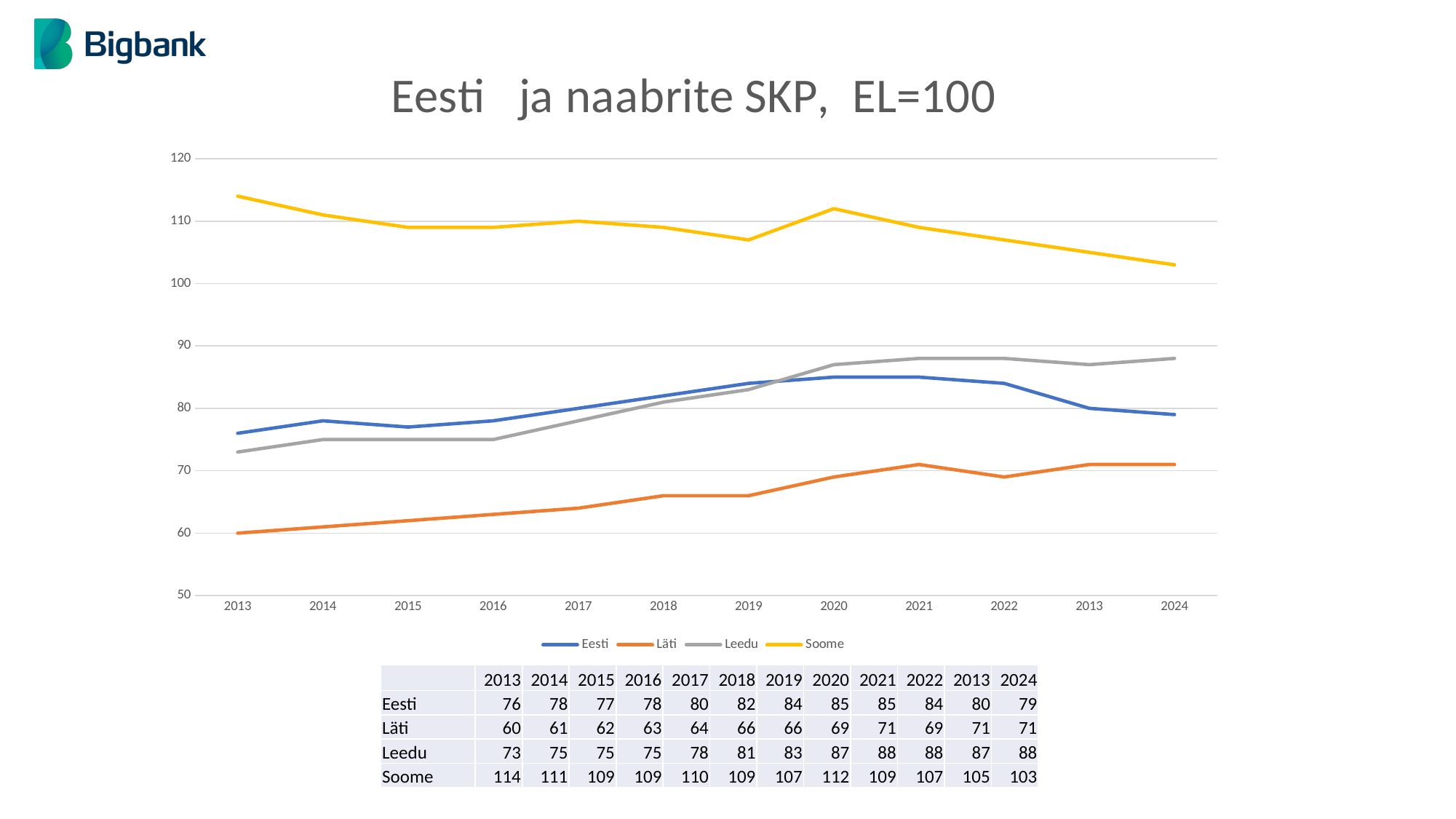
What is the value for Eesti in 2020? 85 How many series does the legend list? 4 Which series has the highest value in 2024? Soome Does the Soome line generally rise or fall from 2013 to 2024? fall What type of chart is shown on the slide? line chart Which series has the lowest value in 2014? Läti What is the difference between the Soome and Eesti values in 2024? 24 What is the title of the chart? Eesti ja naabrite SKP, EL=100 What is the value for Leedu in 2018? 81 What is the value for Soome in 2024? 103 Which is larger in 2022, the value for Eesti or the value for Leedu? Leedu What is the value for Läti in 2021? 71